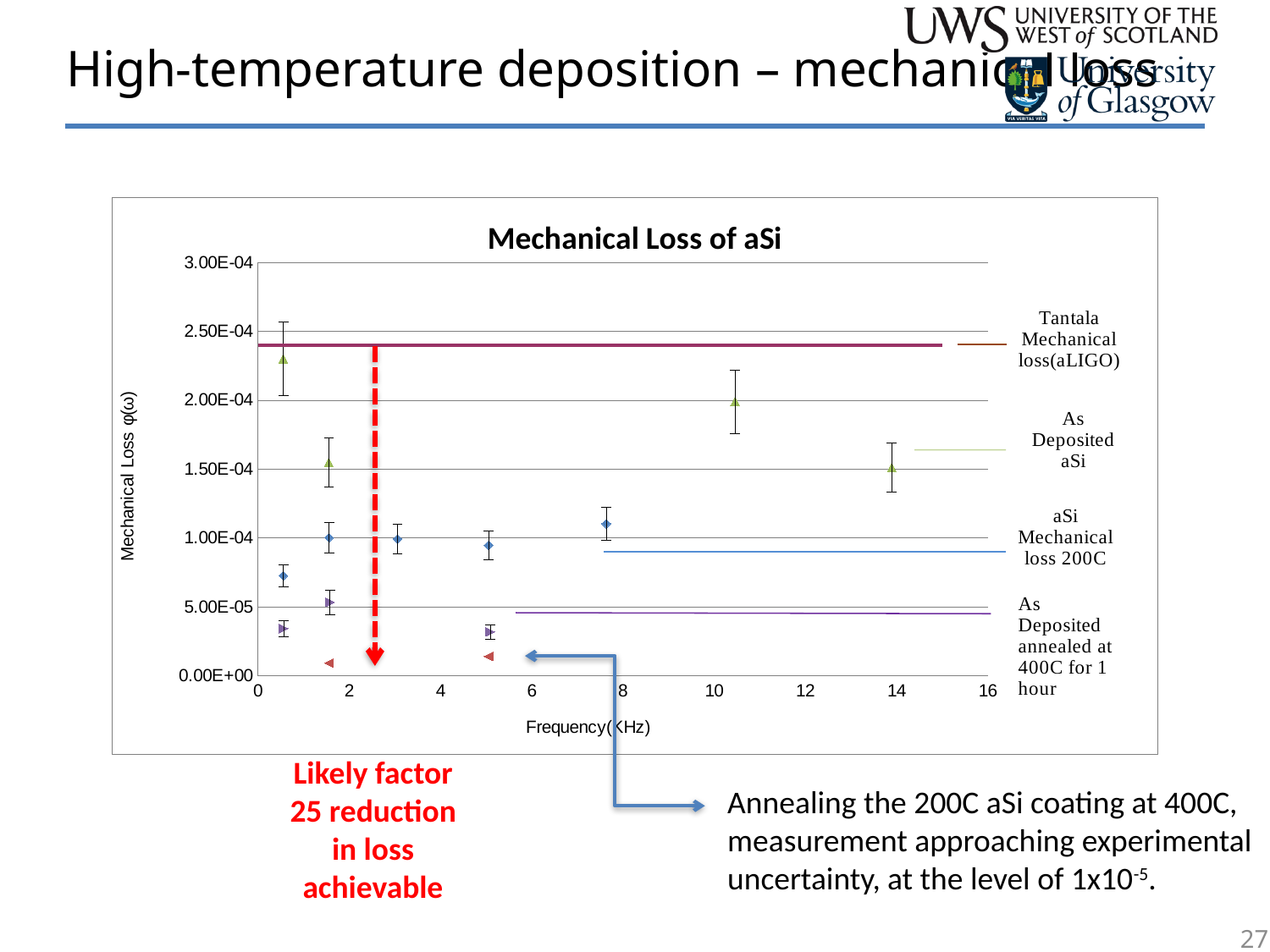
What kind of chart is shown on the slide? scatter chart Is the Tantala Mechanical loss (aLIGO) line greater or less than 2.50E-04? less How many series does the chart legend list? 4 What is the label of the x axis? Frequency(KHz) Is the As Deposited annealed at 400C for 1 hour point near 5 kHz greater or less than 5.00E-05? less Which series has the lowest mechanical loss values on the chart? As Deposited annealed at 400C for 1 hour How many data points are plotted for the As Deposited aSi series? 4 Which series has the highest mechanical loss values on the chart? Tantala Mechanical loss (aLIGO) Is the aSi Mechanical loss 200C point near 0.5 kHz greater or less than 1.00E-04? less What is the title of the chart? Mechanical Loss of aSi